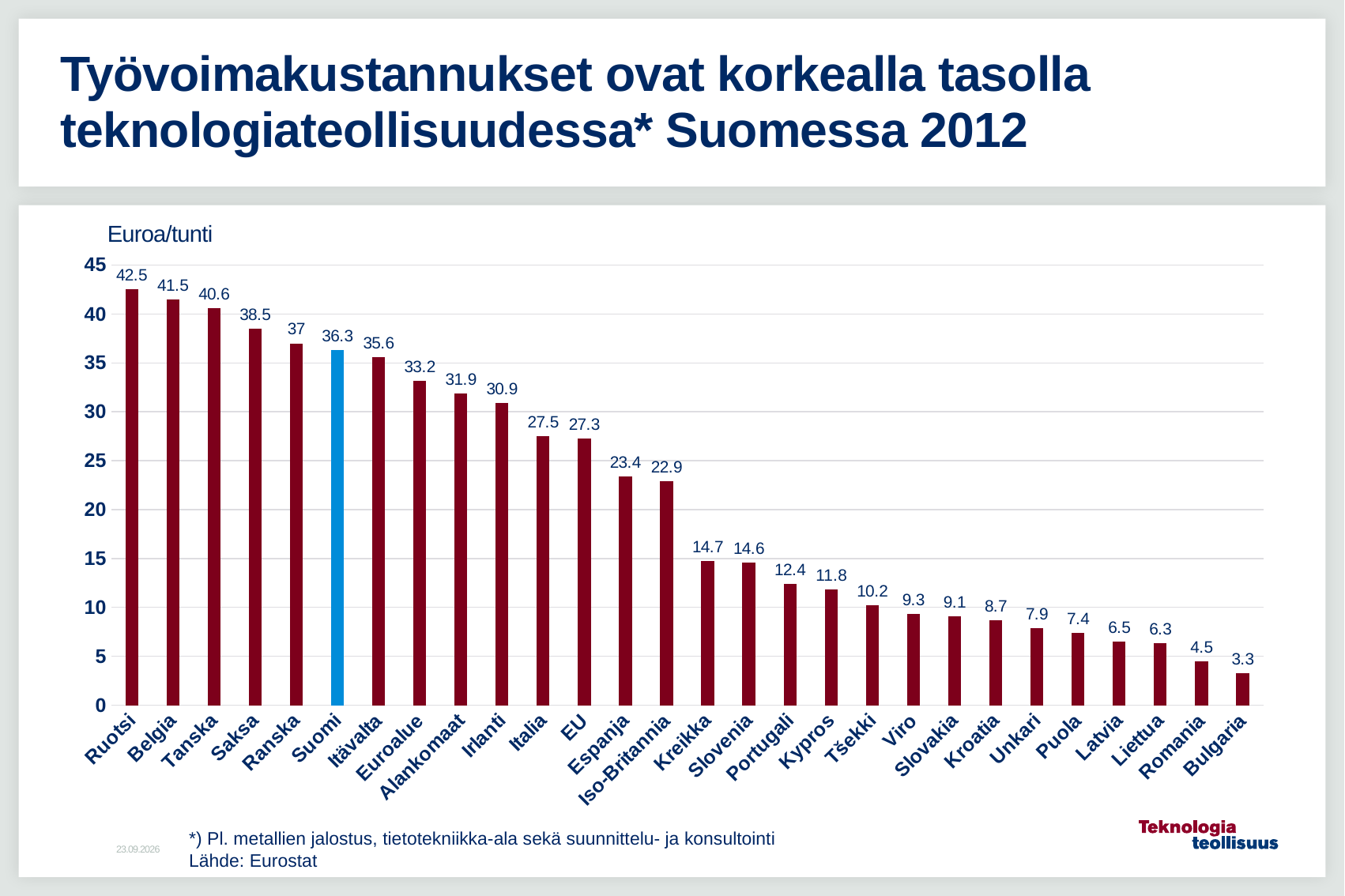
What is the difference between the values for Ruotsi and Suomi? 6.2 What is the value for Viro? 9.3 What is the value for Saksa? 38.5 Which country has the highest value? Ruotsi How many countries or regions are shown on the chart? 28 Which country has the lowest value? Bulgaria What is the value for Iso-Britannia? 22.9 What kind of chart is shown on the slide? Bar chart What unit is shown above the vertical axis? Euroa/tunti What is the difference between the values for Euroalue and EU? 5.9 Which has a larger value, Belgia or Tanska? Belgia What is the value for Suomi? 36.3